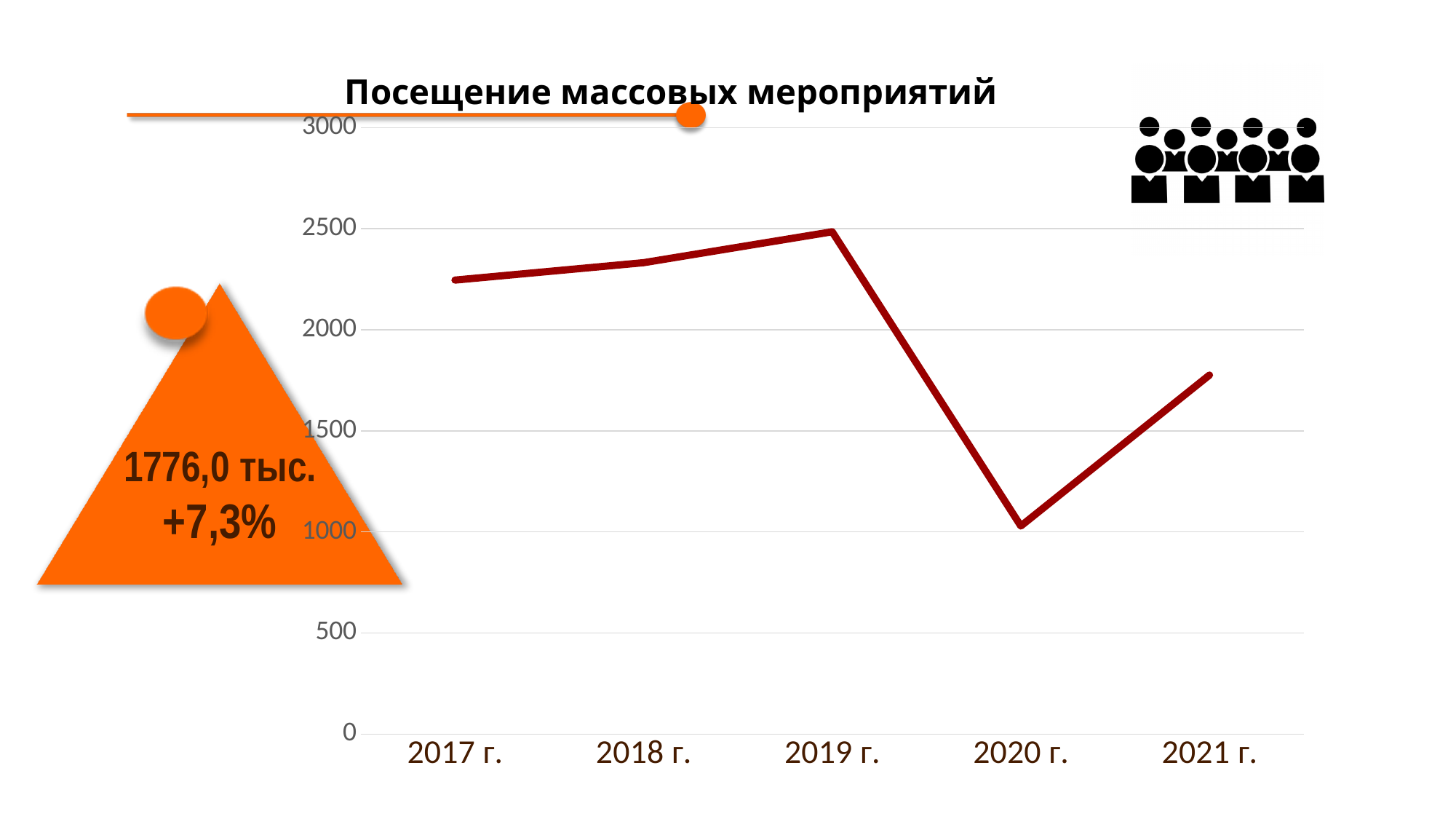
Does the line rise or fall from 2019 г. to 2020 г.? fall Is the value for 2020 г. greater or less than 1500? less Does the line rise or fall from 2017 г. to 2019 г.? rise Which year has the highest value on the chart? 2019 г. Which is larger, the value for 2018 г. or the value for 2020 г.? 2018 г. Which year has the lowest value on the chart? 2020 г. What is the title of the chart? Посещение массовых мероприятий Is the value for 2019 г. greater or less than 2000? greater Is the value for 2021 г. greater or less than 1500? greater What kind of chart is shown on the slide? line chart How many years are plotted along the x axis of the chart? 5